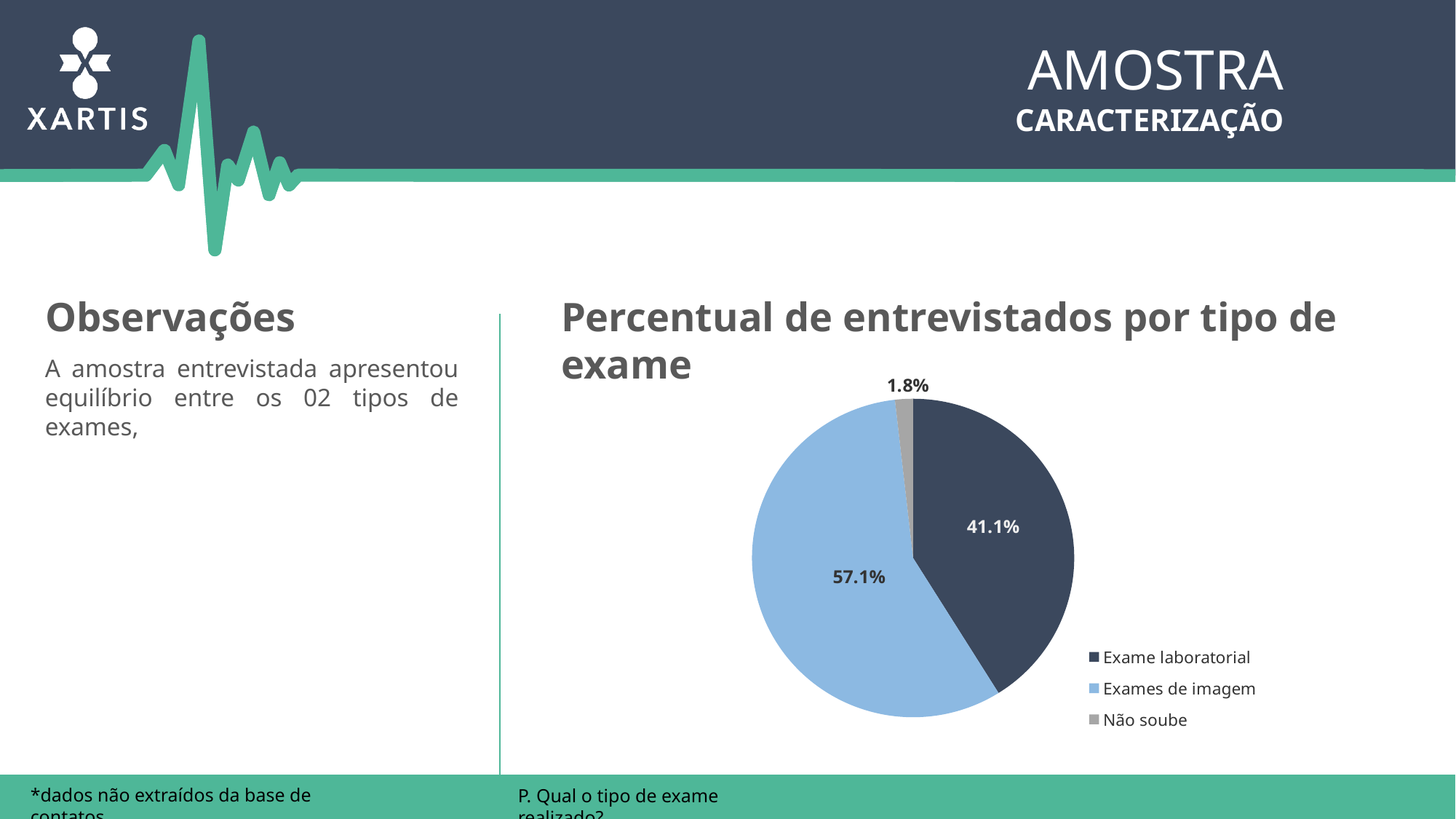
How many categories does the pie chart show? 3 What percentage of respondents had 'Exame laboratorial'? 41.1% How many entries does the legend list? 3 What is the title of the chart? Percentual de entrevistados por tipo de exame What percentage of respondents had 'Exames de imagem'? 57.1% Which is larger: the share for 'Exame laboratorial' or for 'Exames de imagem'? Exames de imagem Which colour represents 'Não soube' in the pie chart? grey What percentage of respondents answered 'Não soube'? 1.8% Which category has the smallest share of respondents? Não soube Which exam type has the largest share of respondents? Exames de imagem What is the difference in percentage points between 'Exames de imagem' and 'Exame laboratorial'? 16.0% What type of chart is shown on the slide? pie chart